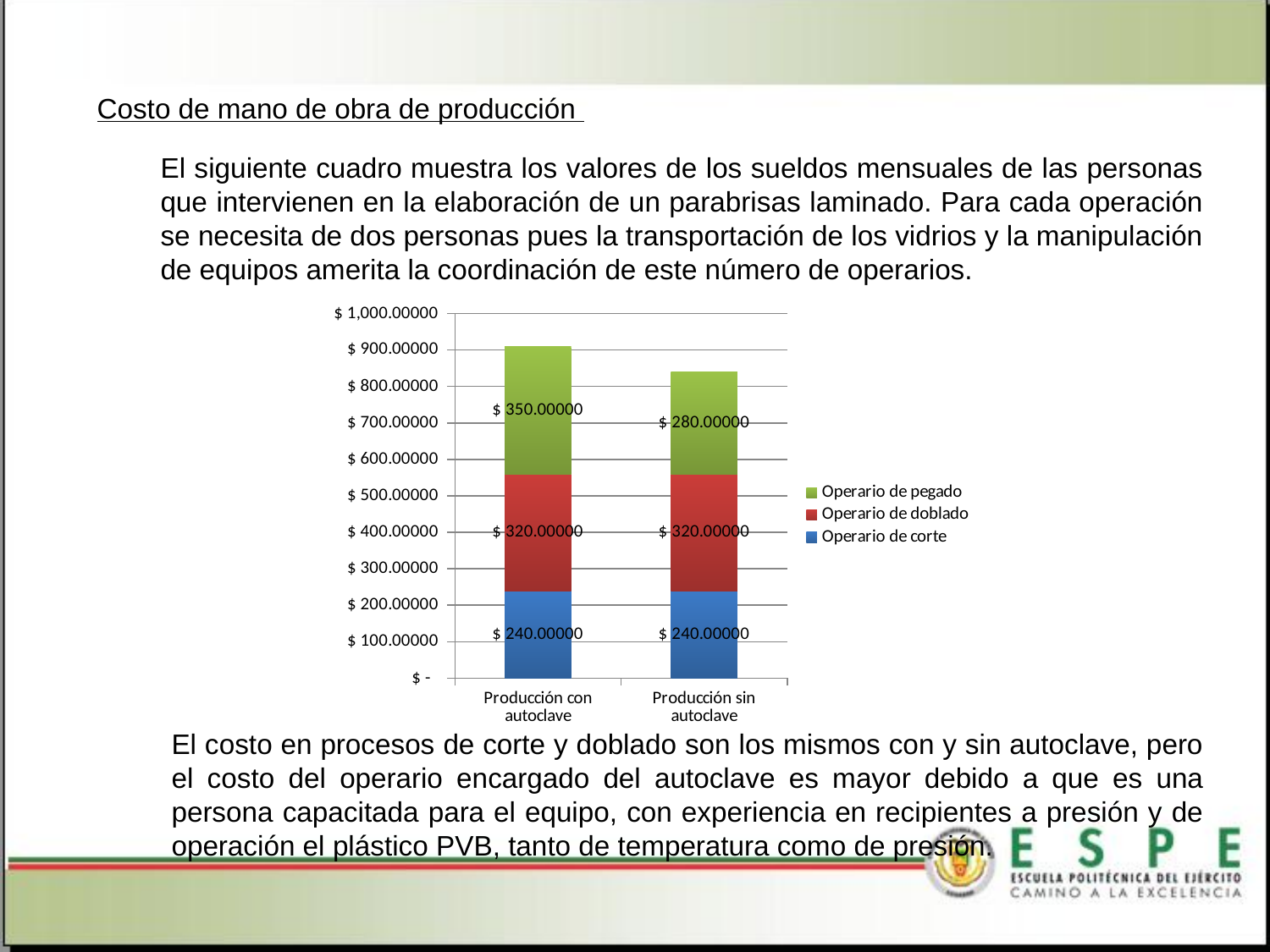
Is the total of the stacked bar for Producción sin autoclave greater or less than $ 900.00000? less What is the difference between the Operario de pegado values for Producción con autoclave and Producción sin autoclave? $ 70.00000 What is the value for Operario de pegado in Producción sin autoclave? $ 280.00000 What kind of chart is shown on the slide? Stacked bar chart Which category has the larger Operario de pegado value, Producción con autoclave or Producción sin autoclave? Producción con autoclave What is the value for Operario de doblado in Producción con autoclave? $ 320.00000 What is the value for Operario de pegado in Producción con autoclave? $ 350.00000 What is the total of the stacked bar for Producción sin autoclave? $ 840.00000 What is the total of the stacked bar for Producción con autoclave? $ 910.00000 How many series does the chart legend list? 3 What is the value for Operario de corte in Producción sin autoclave? $ 240.00000 How many categories are shown on the x axis of the chart? 2